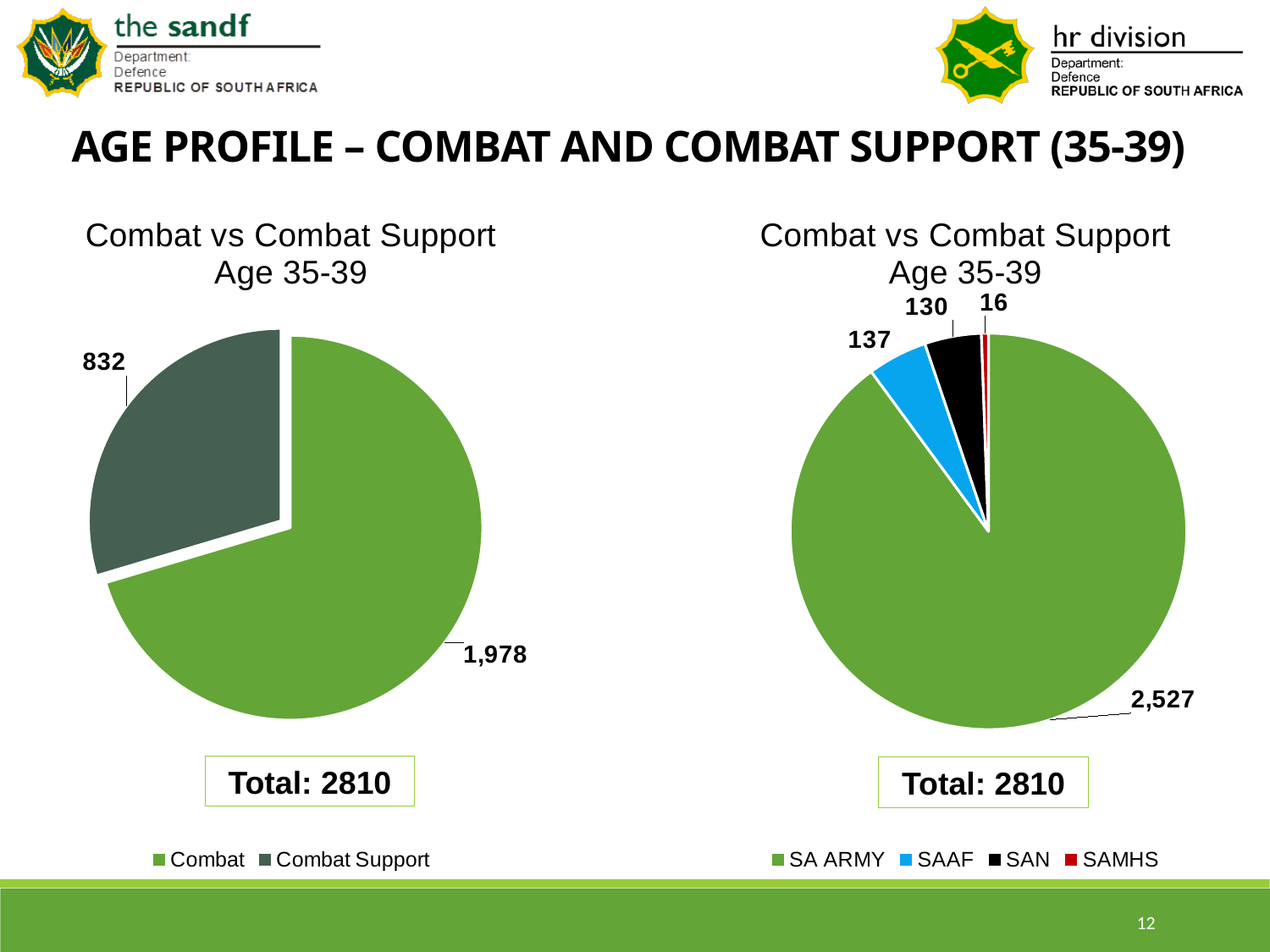
How many categories does the legend of the right pie chart list? 4 In the left pie chart, what is the value for Combat? 1,978 In the right pie chart, which category has the smallest slice? SAMHS In the left pie chart, what is the difference between the Combat and Combat Support values? 1,146 What type of chart is the left chart? Pie chart In the right pie chart, which is larger, SAAF or SAN? SAAF In the right pie chart, what is the difference between the SAAF and SAN values? 7 In the right pie chart, what is the value for SAMHS? 16 In the left pie chart, what is the value for Combat Support? 832 In the right pie chart, what is the value for SA ARMY? 2,527 In the right pie chart, which category has the largest slice? SA ARMY What total is shown below the right pie chart? Total: 2810